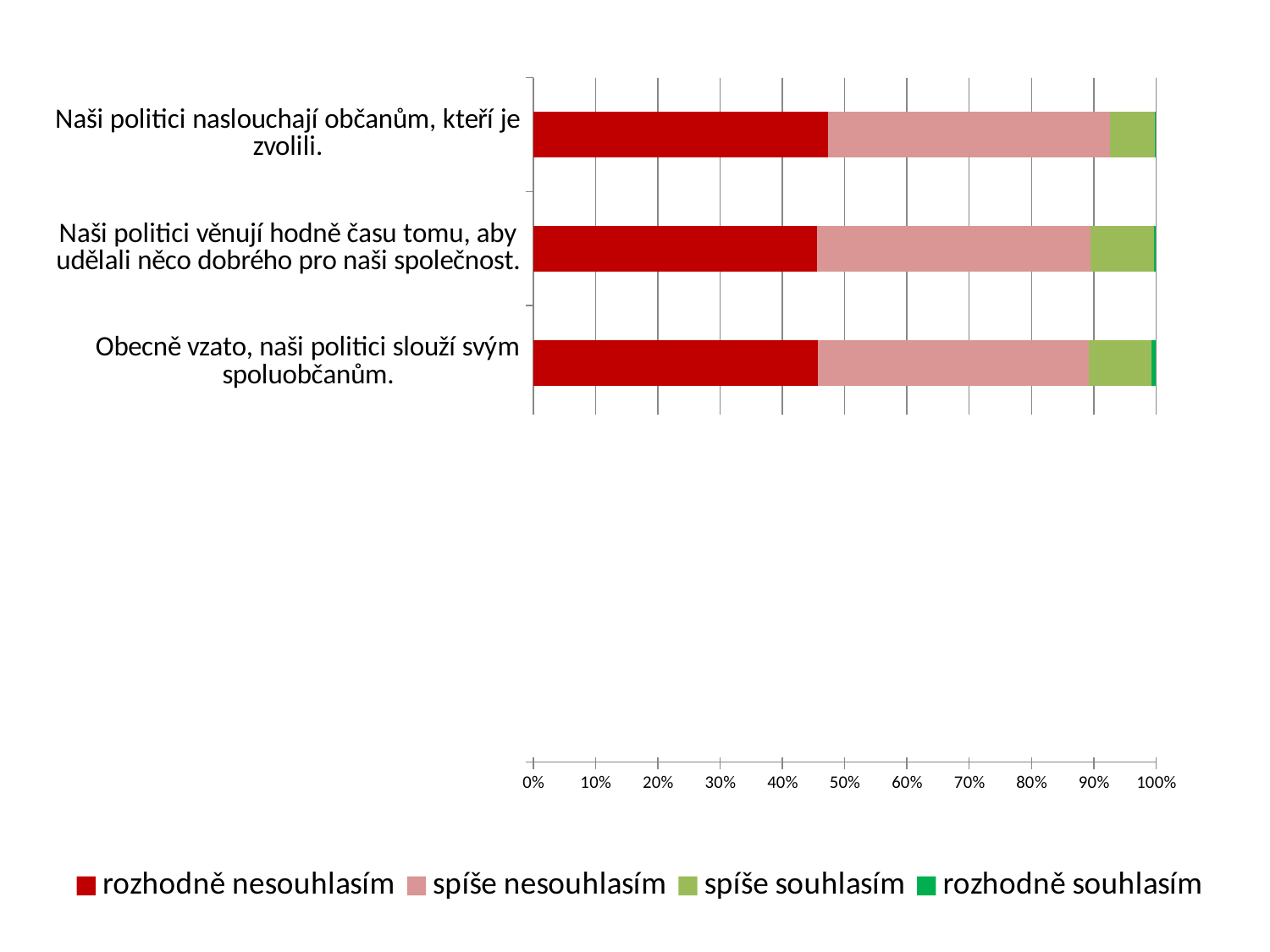
How many series does the legend list? 4 Is the 'rozhodně nesouhlasím' value for 'Naši politici naslouchají občanům, kteří je zvolili.' greater or less than 50%? less What is the first entry in the legend? rozhodně nesouhlasím Which legend entry is shown in dark red? rozhodně nesouhlasím How many statements (categories) are plotted on the chart? 3 Which is larger: the 'spíše souhlasím' segment for 'Naši politici naslouchají občanům, kteří je zvolili.' or for 'Naši politici věnují hodně času tomu, aby udělali něco dobrého pro naši společnost.'? Naši politici věnují hodně času tomu, aby udělali něco dobrého pro naši společnost. Is the 'rozhodně nesouhlasím' value for 'Naši politici věnují hodně času tomu, aby udělali něco dobrého pro naši společnost.' greater or less than 40%? greater Which series has the smallest segment in every bar? rozhodně souhlasím Is the 'rozhodně nesouhlasím' value for 'Obecně vzato, naši politici slouží svým spoluobčanům.' greater or less than 50%? less What kind of chart is shown on the slide? stacked bar chart